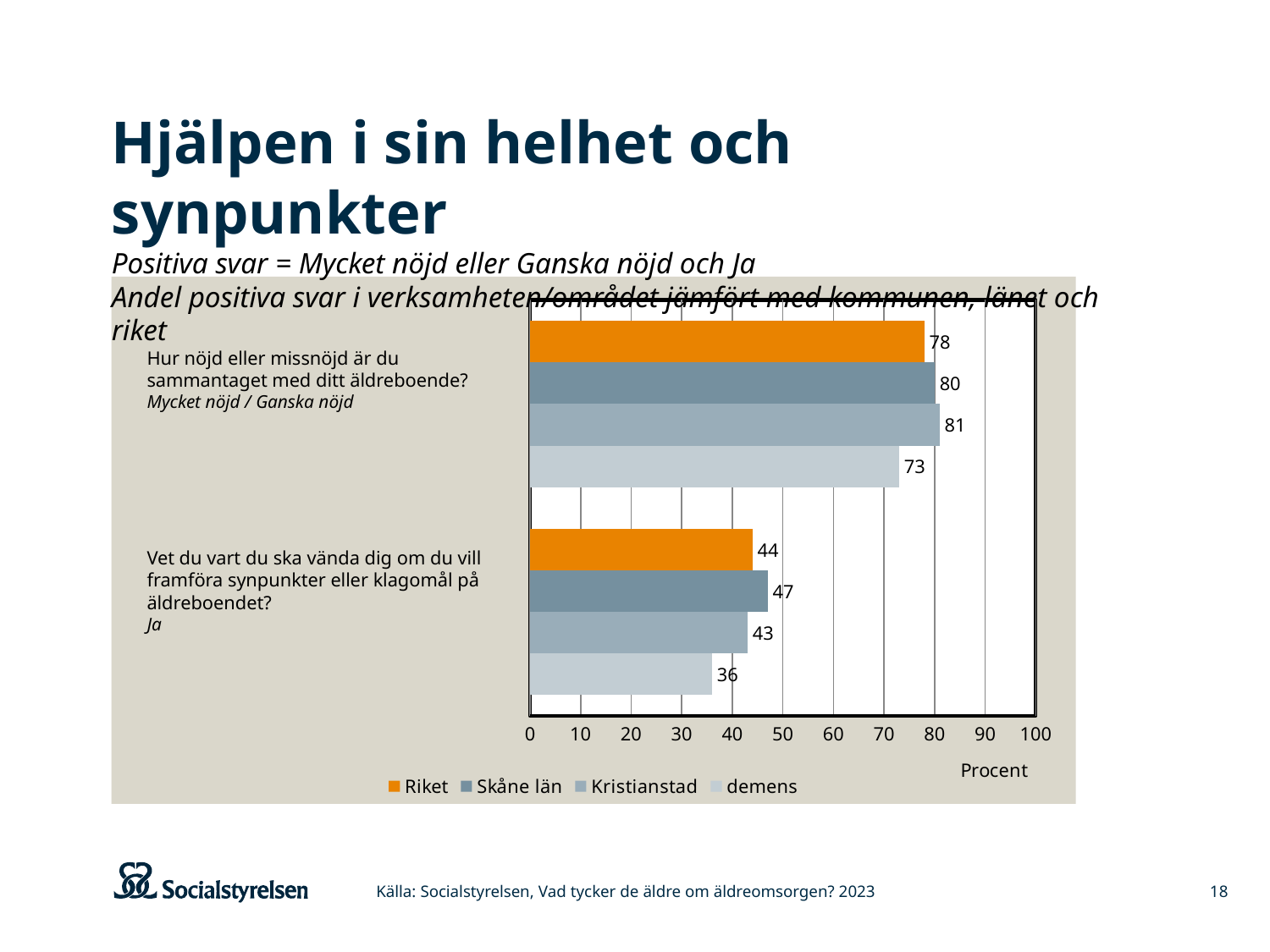
What label is shown on the horizontal axis of the chart? Procent How many series does the legend list? 4 What is the value for Kristianstad on the question about overall satisfaction with the care home? 81 What is the difference between the Kristianstad value and the demens value on the question about overall satisfaction with the care home? 8 What kind of chart is shown on the slide? Bar chart Which is larger on the question about knowing where to turn with complaints: the value for Riket or the value for demens? Riket What is the difference between the Skåne län value and the Kristianstad value on the question about knowing where to turn with complaints? 4 Which series has the lowest value on the question about overall satisfaction with the care home? demens What is the value for demens on the question about knowing where to turn with complaints (Vet du vart du ska vända dig...)? 36 What is the value for Riket on the question about overall satisfaction with the care home (Hur nöjd eller missnöjd är du sammantaget med ditt äldreboende?)? 78 Which series has the highest value on the question about knowing where to turn with complaints? Skåne län What is the value for Skåne län on the question about knowing where to turn with complaints? 47